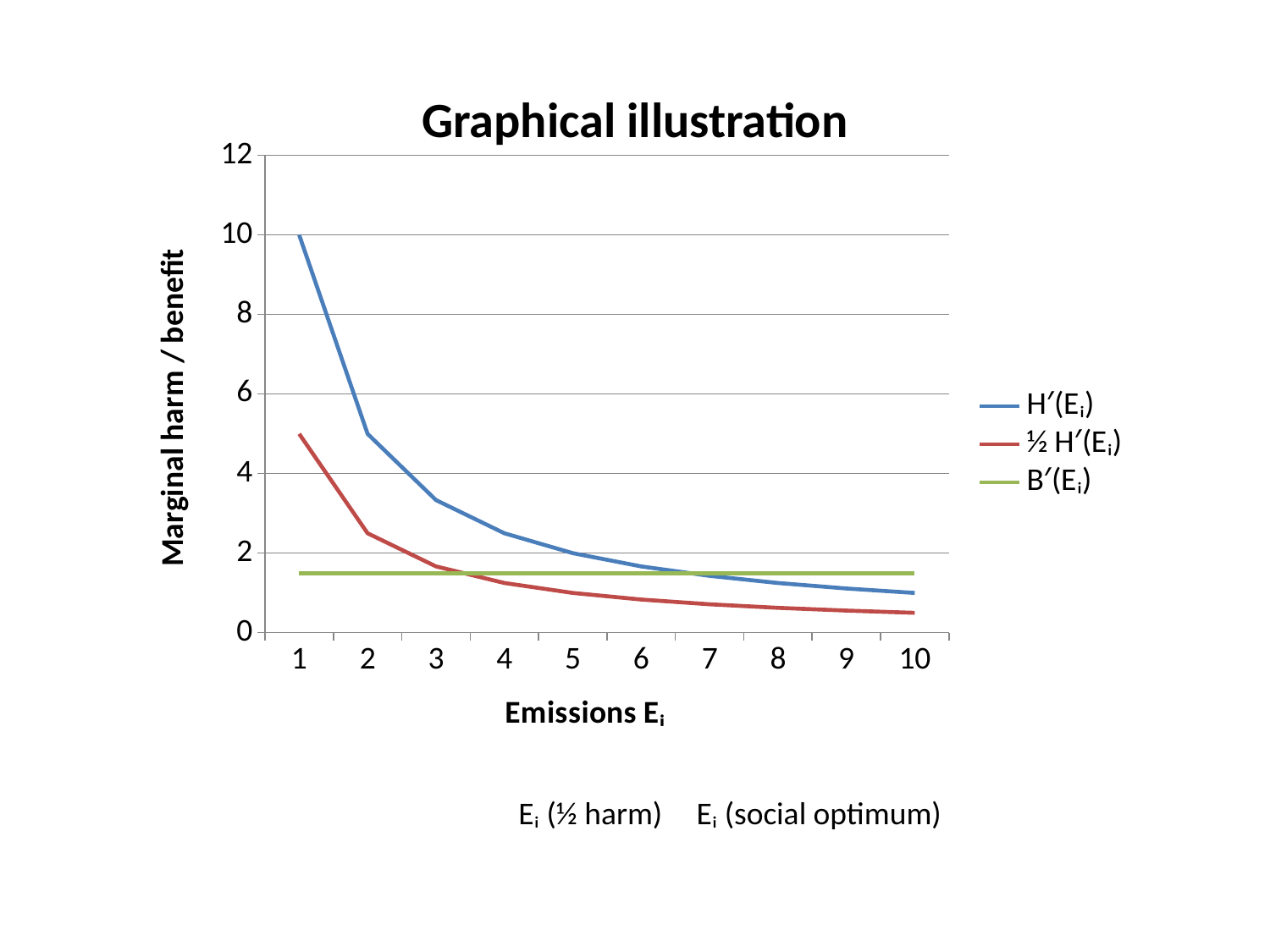
Is the value of H′(Eᵢ) at emissions level 2 greater or less than 4? greater What is the title of the chart? Graphical illustration Does the H′(Eᵢ) series rise or fall as emissions increase? fall What is the label of the y axis? Marginal harm / benefit Which series is higher at emissions level 1, H′(Eᵢ) or ½ H′(Eᵢ)? H′(Eᵢ) Is the value of B′(Eᵢ) greater or less than 2? less How many series does the legend list? 3 What is the value of H′(Eᵢ) at emissions level 1? 10 Which series has the highest value at emissions level 10? B′(Eᵢ) Is the value of ½ H′(Eᵢ) at emissions level 2 greater or less than 4? less What kind of chart is shown on the slide? line chart How many emission levels are plotted along the x axis? 10